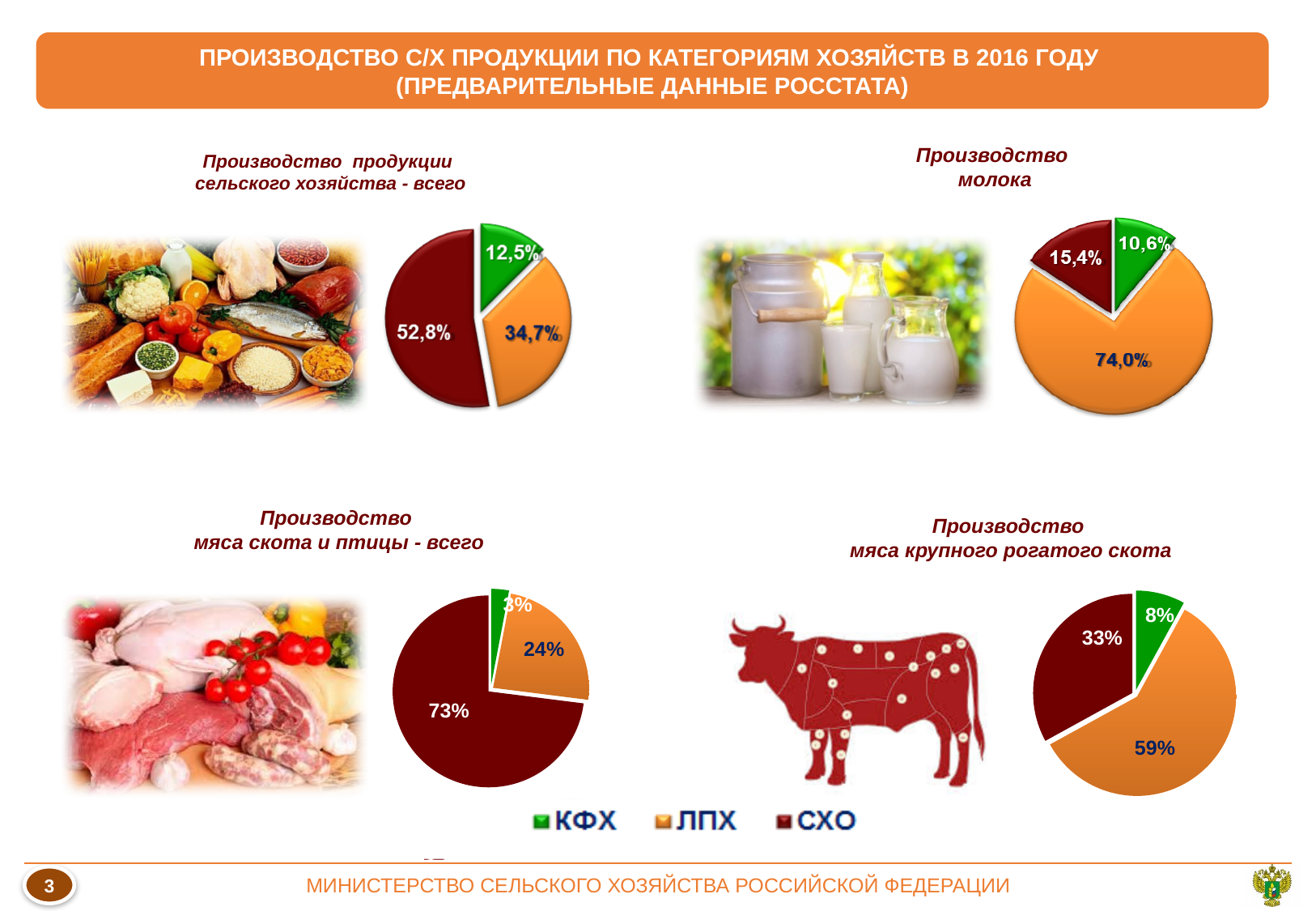
In the 'Производство мяса скота и птицы - всего' pie chart, which category has the smallest share? КФХ In the 'Производство молока' pie chart, what share does ЛПХ have? 74,0% In the 'Производство мяса крупного рогатого скота' pie chart, which is larger: the share of ЛПХ or the share of СХО? ЛПХ In the 'Производство продукции сельского хозяйства - всего' pie chart, what is the difference between the СХО share and the ЛПХ share? 18,1% In the 'Производство мяса крупного рогатого скота' pie chart, what share does КФХ have? 8% In the 'Производство молока' pie chart, which category has the largest share? ЛПХ In the 'Производство мяса скота и птицы - всего' pie chart, what share does ЛПХ have? 24% Which colour represents СХО in the legend? Dark red In the 'Производство продукции сельского хозяйства - всего' pie chart, what share does СХО have? 52,8% How many series does the legend list? 3 What kind of chart is used for 'Производство молока'? Pie chart How many pie charts are on the slide? 4